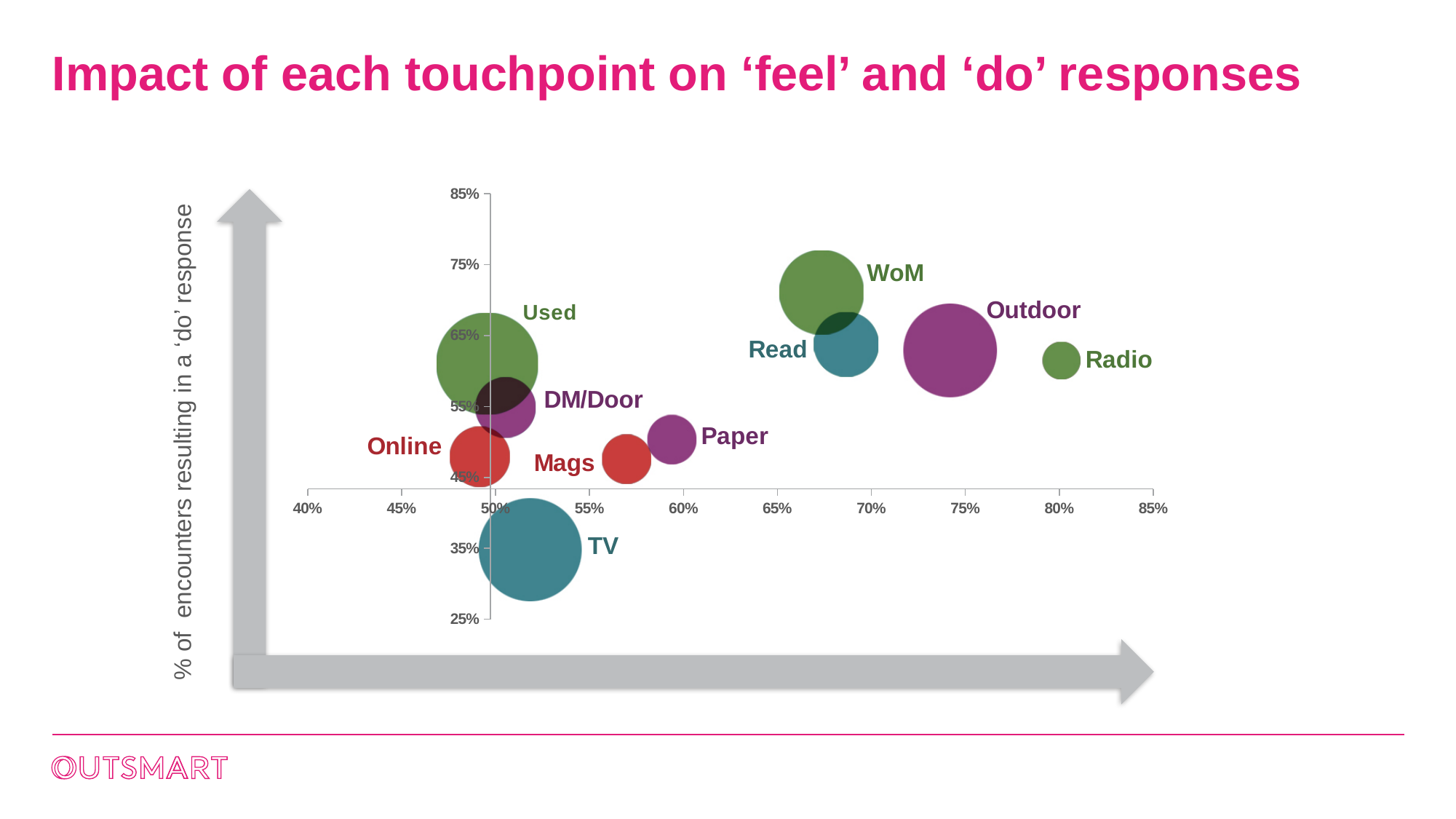
Which touchpoint has the lowest position on the vertical ('do' response) axis? TV Which touchpoint has the highest position on the vertical ('do' response) axis? WoM Is the vertical-axis value for WoM greater or less than 65%? greater Which touchpoint is drawn with the smallest bubble? Radio Which touchpoint is positioned furthest to the right on the horizontal axis? Radio Which is positioned higher on the vertical axis, WoM or TV? WoM Is the horizontal-axis value for Outdoor greater or less than 70%? greater Is the vertical-axis value for TV greater or less than 45%? less What kind of chart is shown on the slide? bubble chart How many touchpoint bubbles are plotted on the chart? 10 What is the label of the vertical axis? % of encounters resulting in a 'do' response